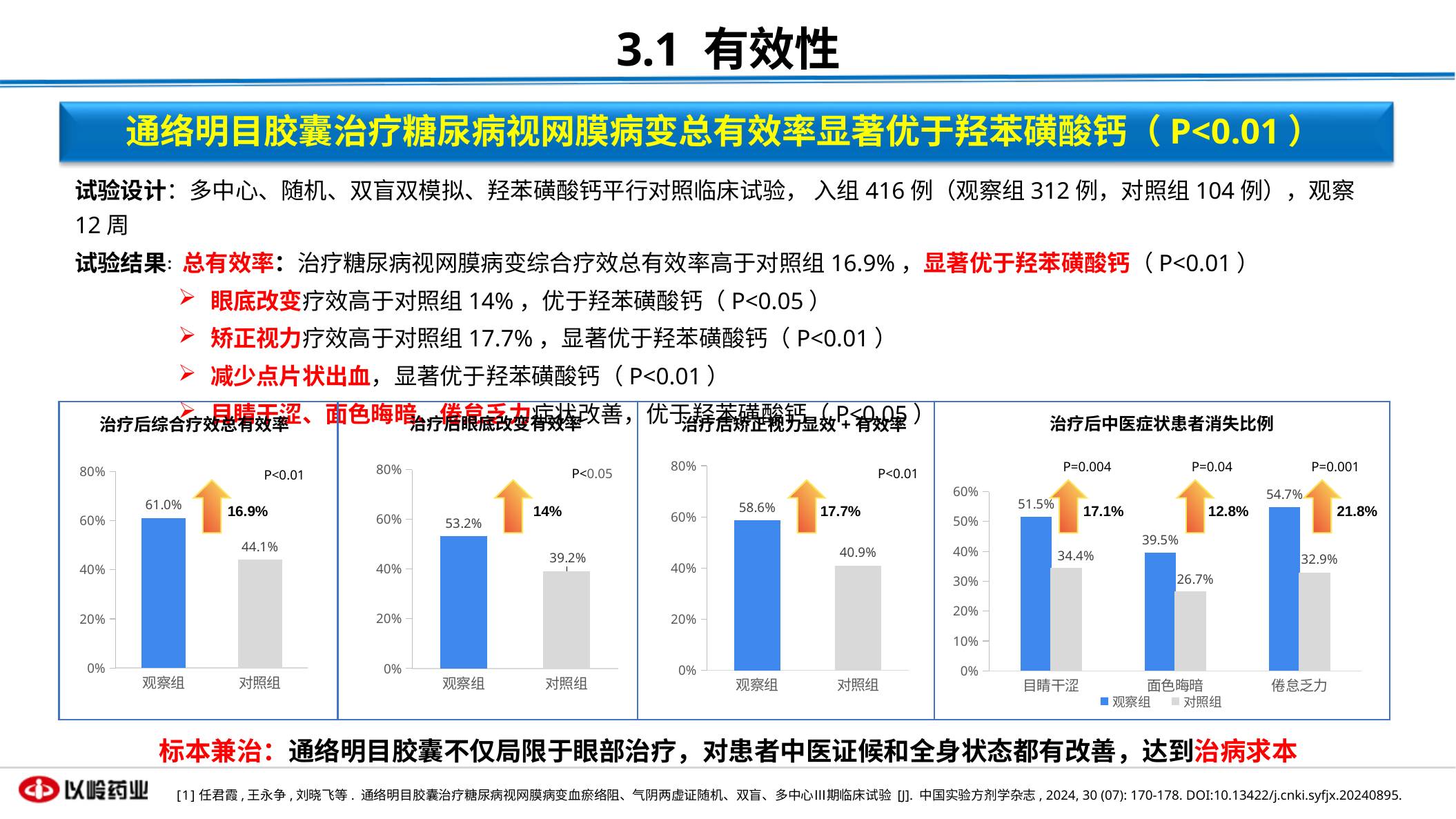
In the rightmost chart (治疗后中医症状患者消失比例), which category has the lowest value for 对照组? 面色晦暗 In the rightmost chart (治疗后中医症状患者消失比例), what is the value for 观察组 in the 倦怠乏力 category? 54.7% In the third chart from the left (治疗后矫正视力显效＋有效率), what is the difference between 观察组 and 对照组? 17.7% In the leftmost chart (治疗后综合疗效总有效率), what is the value for 对照组? 44.1% In the leftmost chart (治疗后综合疗效总有效率), what is the difference between 观察组 and 对照组? 16.9% In the rightmost chart (治疗后中医症状患者消失比例), how many categories are shown on the x axis? 3 In the leftmost chart (治疗后综合疗效总有效率), what is the value for 观察组? 61.0% What type of chart is the leftmost chart (治疗后综合疗效总有效率)? Bar chart In the third chart from the left (治疗后矫正视力显效＋有效率), what is the value for 对照组? 40.9% In the second chart from the left (治疗后眼底改变有效率), what is the value for 观察组? 53.2% In the second chart from the left (治疗后眼底改变有效率), which group has the higher value, 观察组 or 对照组? 观察组 In the rightmost chart (治疗后中医症状患者消失比例), how many series does the legend list? 2